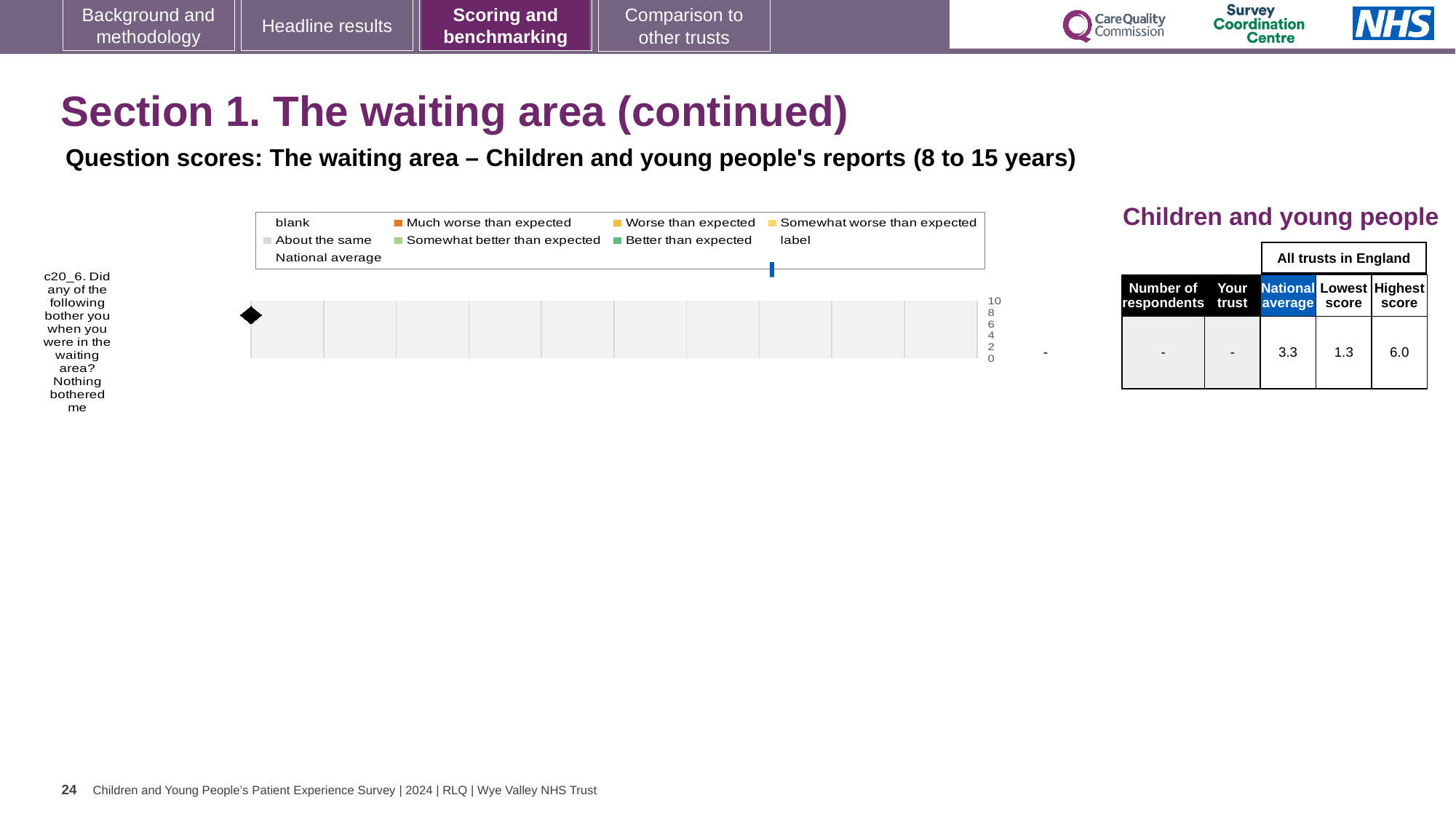
In the table next to the chart, what is the lowest score among all trusts in England? 1.3 Which question is plotted on the chart? c20_6. Did any of the following bother you when you were in the waiting area? Nothing bothered me What kind of chart is shown on the slide? bar chart How many entries does the chart legend list? 9 In the table next to the chart, what is shown as the score for 'Your trust'? - In the table next to the chart, what is the national average score for this question? 3.3 In the table next to the chart, what is the difference between the highest score and the lowest score? 4.7 In the table next to the chart, which is larger: the national average or the lowest score? national average What colour is the 'Much worse than expected' legend entry? orange In the table next to the chart, what is the highest score among all trusts in England? 6.0 How many question categories are plotted on the chart? 1